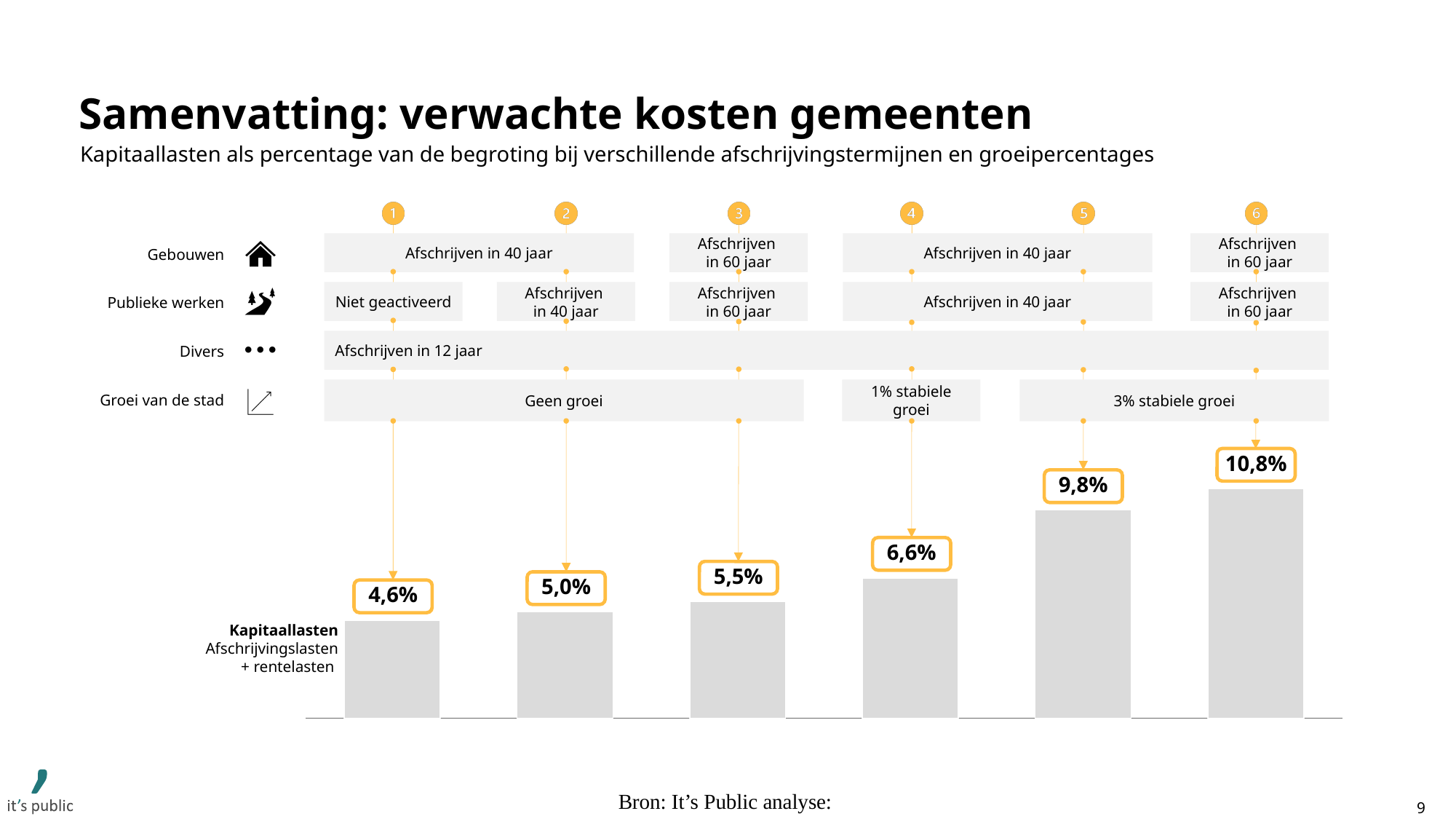
Do the Kapitaallasten values rise or fall from scenario 1 to scenario 6? Rise What is the Kapitaallasten value for scenario 1? 4,6% Which is larger, the Kapitaallasten value for scenario 3 or for scenario 2? Scenario 3 What is the difference between the Kapitaallasten values of scenario 5 and scenario 4? 3,2% What is the Kapitaallasten value for scenario 6? 10,8% Which scenario has the highest Kapitaallasten value? Scenario 6 Which scenario has the lowest Kapitaallasten value? Scenario 1 What growth assumption (Groei van de stad) applies to scenario 4? 1% stabiele groei What is the Kapitaallasten value for scenario 4? 6,6% What kind of chart is used to show the Kapitaallasten values? Bar chart How many scenarios (bars) are shown in the chart? 6 What is the difference between the Kapitaallasten values of scenario 6 and scenario 1? 6,2%